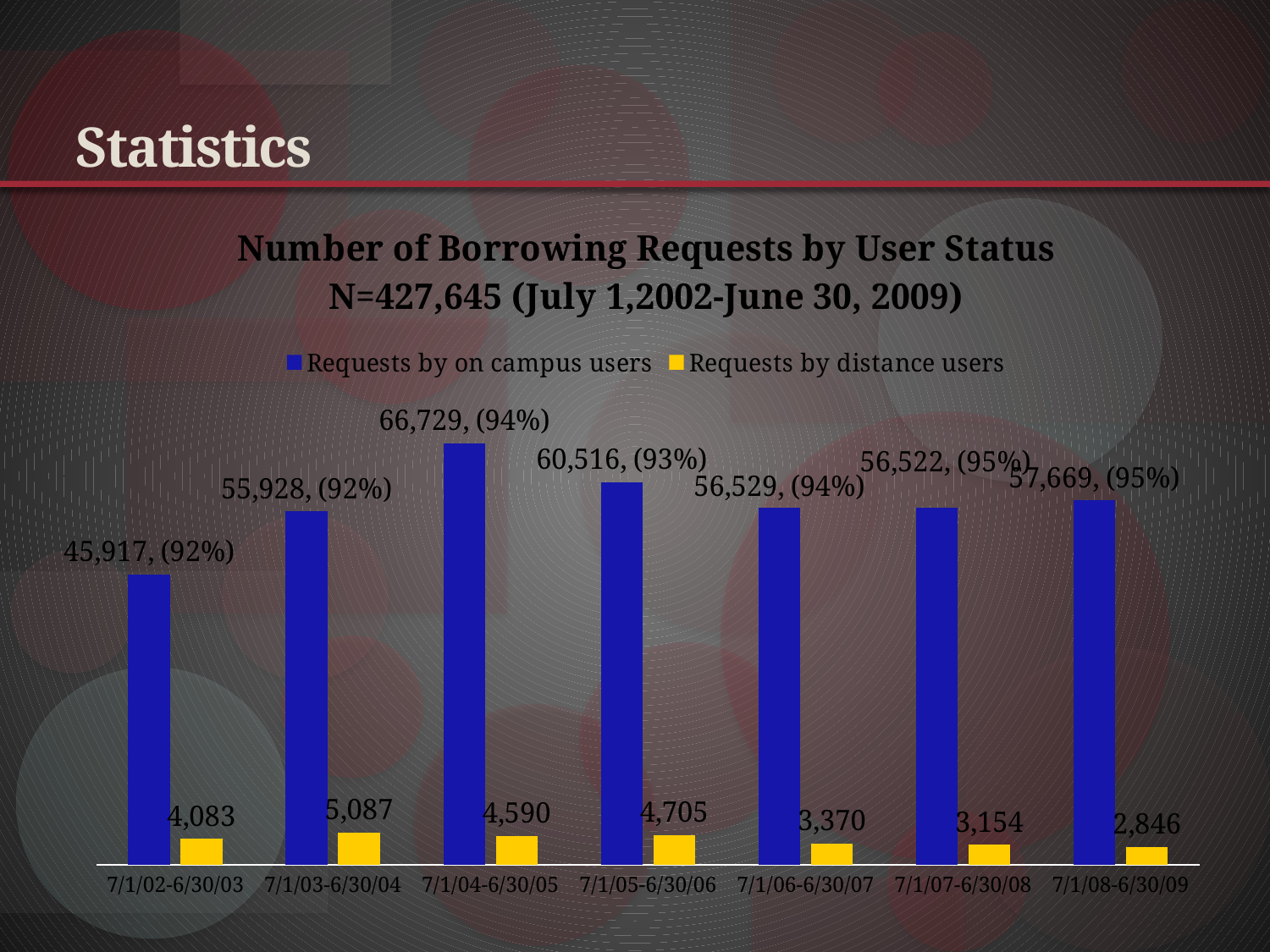
What percentage of requests came from on campus users in 7/1/05-6/30/06? 93% What is the difference between the highest and lowest number of requests by on campus users? 20,812 How many requests by on campus users were there in 7/1/04-6/30/05? 66,729 How many time periods are shown on the x axis? 7 Which period had more requests by on campus users, 7/1/05-6/30/06 or 7/1/06-6/30/07? 7/1/05-6/30/06 What is the total N stated in the chart title? 427,645 What type of chart is shown on the slide? Bar chart How many requests by distance users were there in 7/1/07-6/30/08? 3,154 Which period had the highest number of requests by on campus users? 7/1/04-6/30/05 Do requests by distance users rise or fall from 7/1/05-6/30/06 to 7/1/08-6/30/09? Fall Which period had the lowest number of requests by distance users? 7/1/08-6/30/09 How many series does the legend list? 2